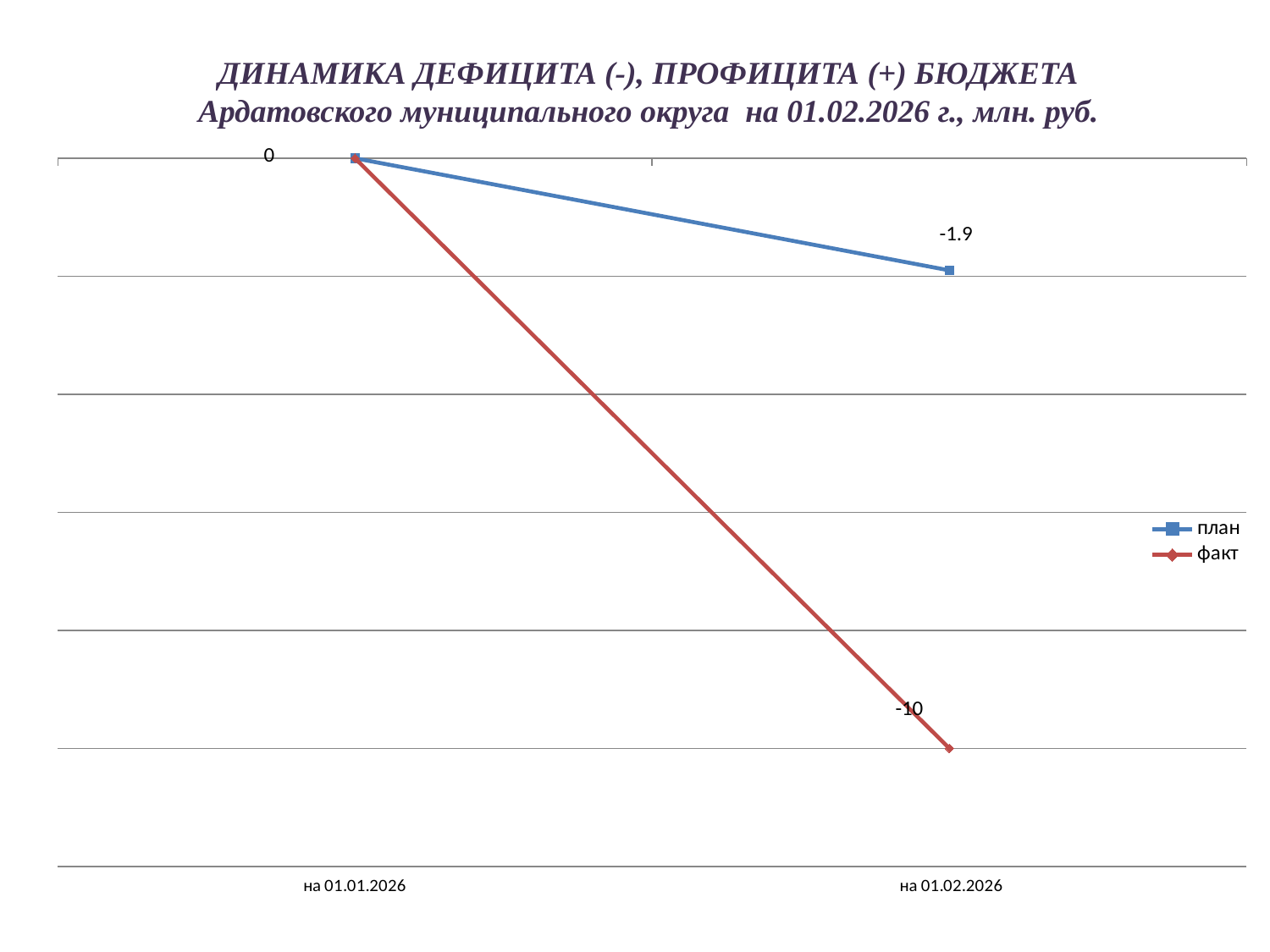
What value is labelled at на 01.01.2026, where both lines start? 0 What are the names of the series in the legend? план, факт How many points are plotted along the x axis for each series? 2 What colour is the line for the факт series? red Which series has the higher value at на 01.02.2026? план What is the value of the план series at на 01.02.2026? -1.9 Which series has the lower value at на 01.02.2026? факт What is the value of the факт series at на 01.02.2026? -10 How many series does the legend list? 2 What type of chart is shown on the slide? line chart Do the values of the факт series rise or fall from на 01.01.2026 to на 01.02.2026? fall What is the difference between the план and факт values at на 01.02.2026? 8.1